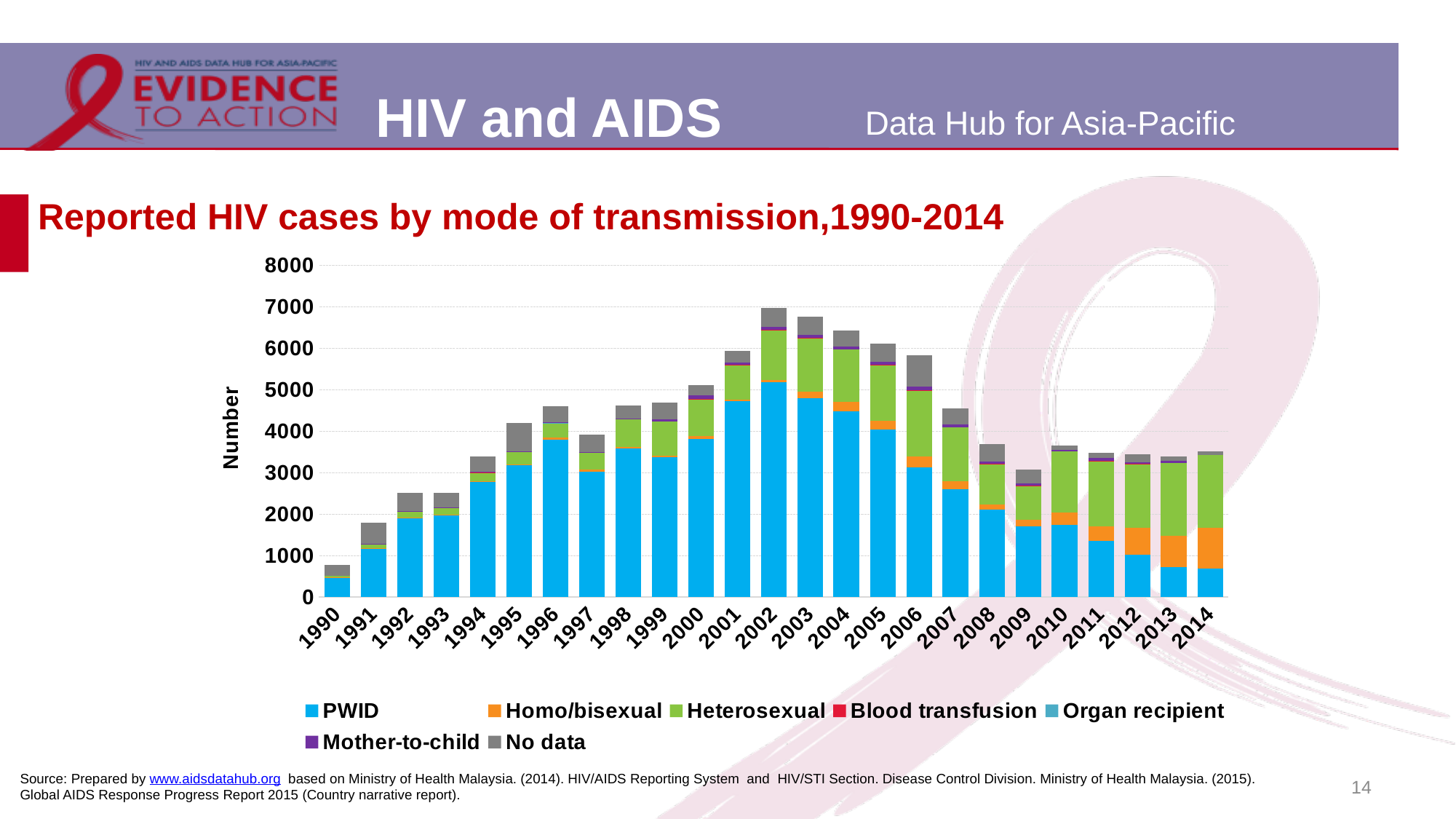
What is the title of the chart? Reported HIV cases by mode of transmission,1990-2014 Do the total reported cases rise or fall from 2002 to 2014? fall What kind of chart is shown on the slide? Stacked bar chart Is the total number of reported cases in 1990 greater or less than 1000? less How many years are shown along the x axis? 25 Is the total number of reported cases in 2014 greater or less than 4000? less Which year has the lowest total number of reported HIV cases? 1990 Is the total number of reported cases in 2002 greater or less than 6000? greater Which year has a larger total of reported cases, 2002 or 2009? 2002 Which year has the highest total number of reported HIV cases? 2002 How many series does the legend list? 7